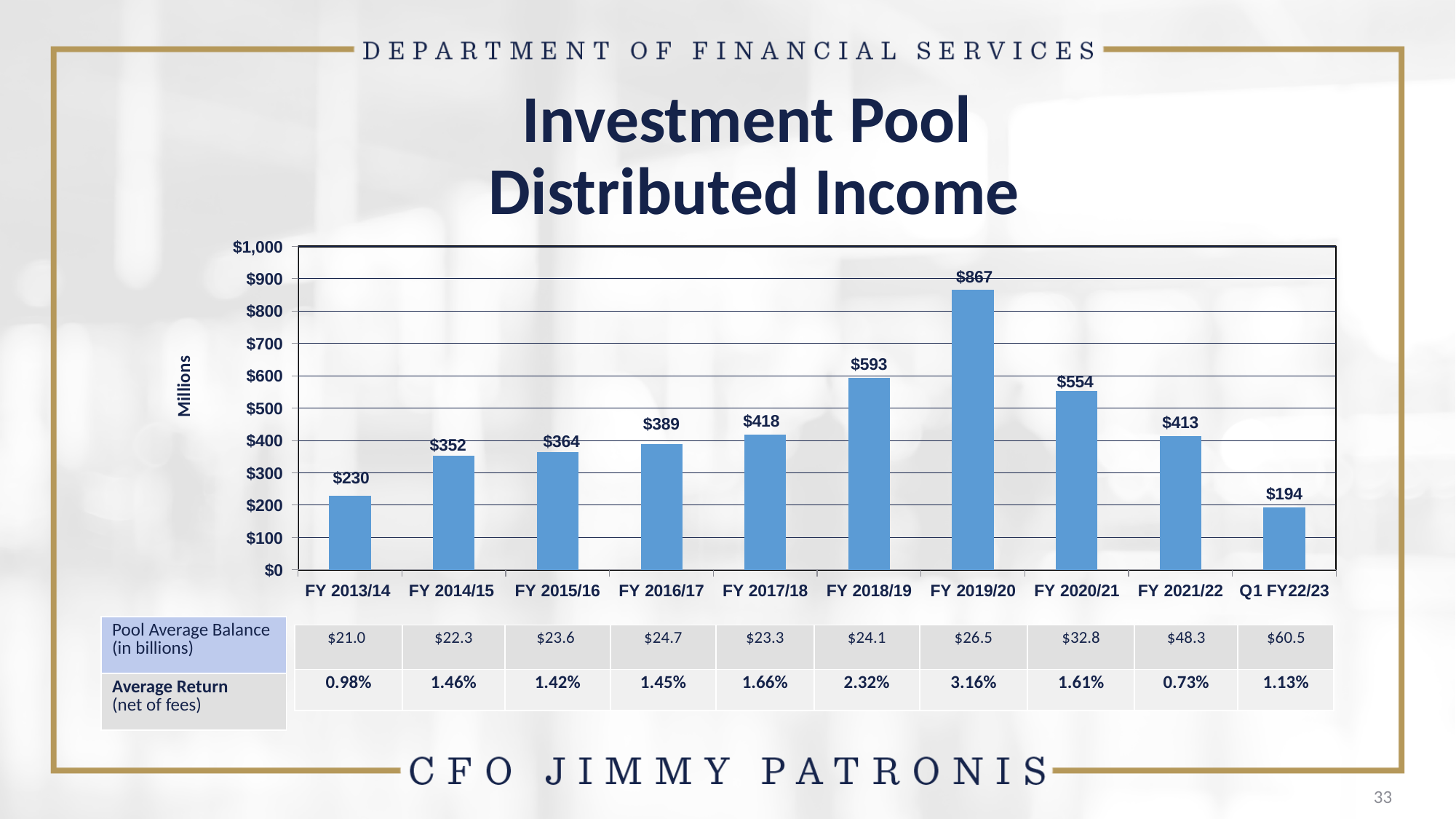
Which fiscal year has the highest distributed income? FY 2019/20 Does the distributed income rise or fall from FY 2013/14 to FY 2016/17? Rise What is the title of the chart? Investment Pool Distributed Income What is the distributed income for FY 2019/20? $867 What is the distributed income for FY 2013/14? $230 What is the distributed income for Q1 FY22/23? $194 Is the distributed income for FY 2018/19 greater or less than $500? greater What kind of chart is shown on the slide? Bar chart Which is larger, the distributed income for FY 2017/18 or FY 2021/22? FY 2017/18 What is the difference in distributed income between FY 2019/20 and FY 2020/21? $313 Which category has the lowest distributed income? Q1 FY22/23 How many categories are shown on the x axis of the chart? 10